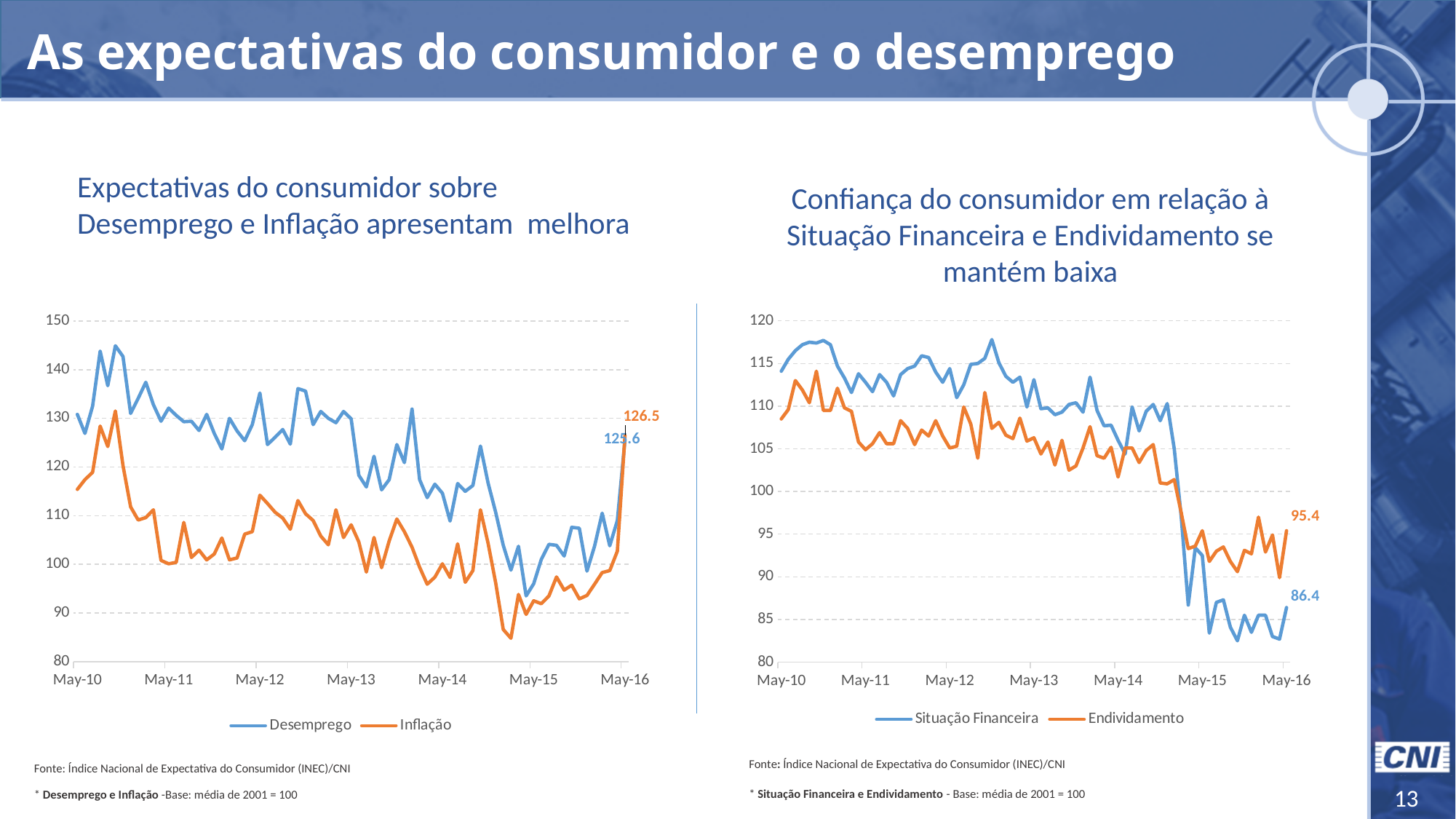
In the right chart (Situação Financeira e Endividamento), what is the value labelled for Endividamento at May-16? 95.4 In the right chart (Situação Financeira e Endividamento), does the Situação Financeira line rise or fall overall from May-10 to May-16? fall In the left chart (Desemprego e Inflação), what is the value labelled for Inflação at May-16? 126.5 How many series does the legend of the left chart (Desemprego e Inflação) list? 2 How many series does the legend of the right chart (Situação Financeira e Endividamento) list? 2 In the right chart (Situação Financeira e Endividamento), what is the difference between the May-16 values of Endividamento and Situação Financeira? 9.0 In the left chart (Desemprego e Inflação), is the value for Desemprego at May-10 greater or less than 120? greater In the right chart (Situação Financeira e Endividamento), which series has the higher value at May-16? Endividamento What are the two legend entries of the left chart (Desemprego e Inflação)? Desemprego and Inflação What kind of chart is the left chart (Desemprego e Inflação)? line chart In the right chart (Situação Financeira e Endividamento), is the value for Situação Financeira at May-10 greater or less than 110? greater In the right chart (Situação Financeira e Endividamento), what is the value labelled for Situação Financeira at May-16? 86.4